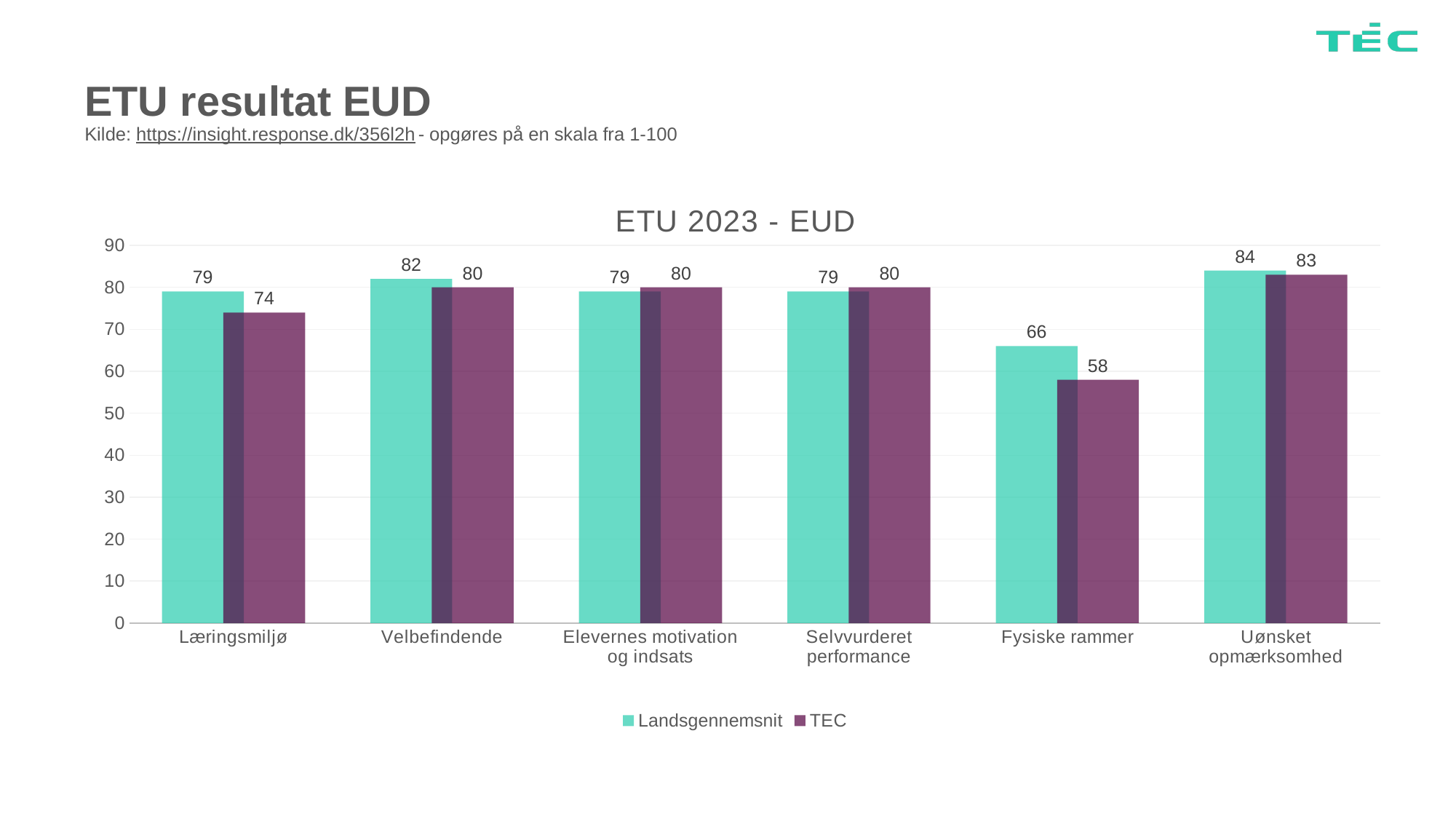
What is the title of the chart? ETU 2023 - EUD What is the difference between the Landsgennemsnit and TEC values for Fysiske rammer? 8 Which category has the lowest TEC value? Fysiske rammer What is the TEC value for Uønsket opmærksomhed? 83 How many series does the legend list? 2 Which category has the highest Landsgennemsnit value? Uønsket opmærksomhed What kind of chart is shown on the slide? Bar chart What is the TEC value for Fysiske rammer? 58 How many categories are shown on the x axis? 6 What is the difference between the Landsgennemsnit and TEC values for Læringsmiljø? 5 Which is larger for Velbefindende, the Landsgennemsnit value or the TEC value? Landsgennemsnit What is the Landsgennemsnit value for Læringsmiljø? 79